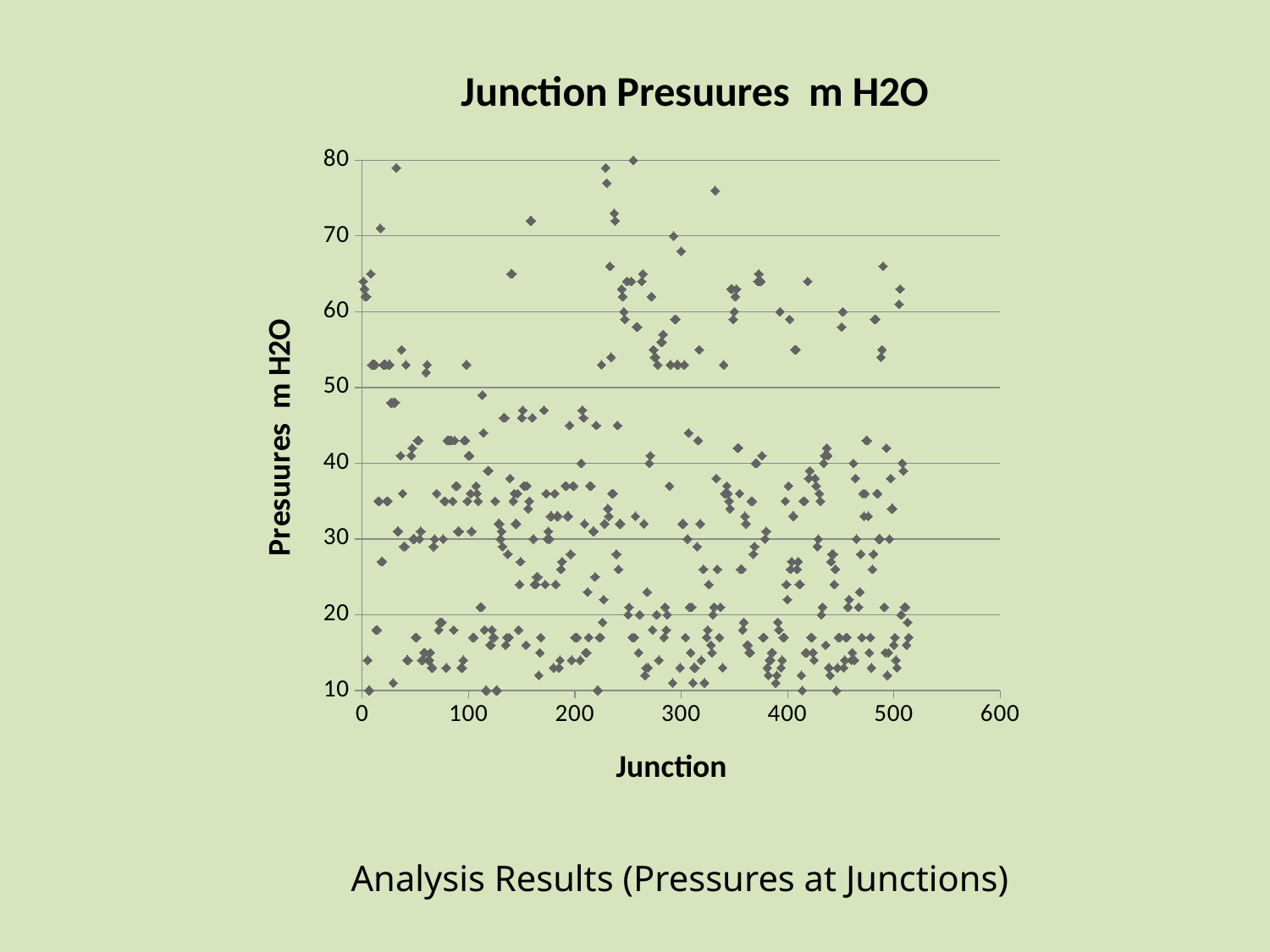
Is the highest plotted pressure in the chart greater or less than 70? greater What is the lowest value shown on the vertical axis of the chart? 10 Is the largest junction number with a plotted point greater or less than 600? less How many tick labels are shown on the vertical axis of the chart? 8 What is the title of the chart? Junction Presuures m H2O What is the label on the horizontal axis of the chart? Junction What is the highest value shown on the horizontal axis of the chart? 600 What kind of chart is shown on the slide? Scatter chart Is the lowest plotted pressure in the chart greater or less than 20? less How many tick labels are shown on the horizontal axis of the chart? 7 What is the highest value shown on the vertical axis of the chart? 80